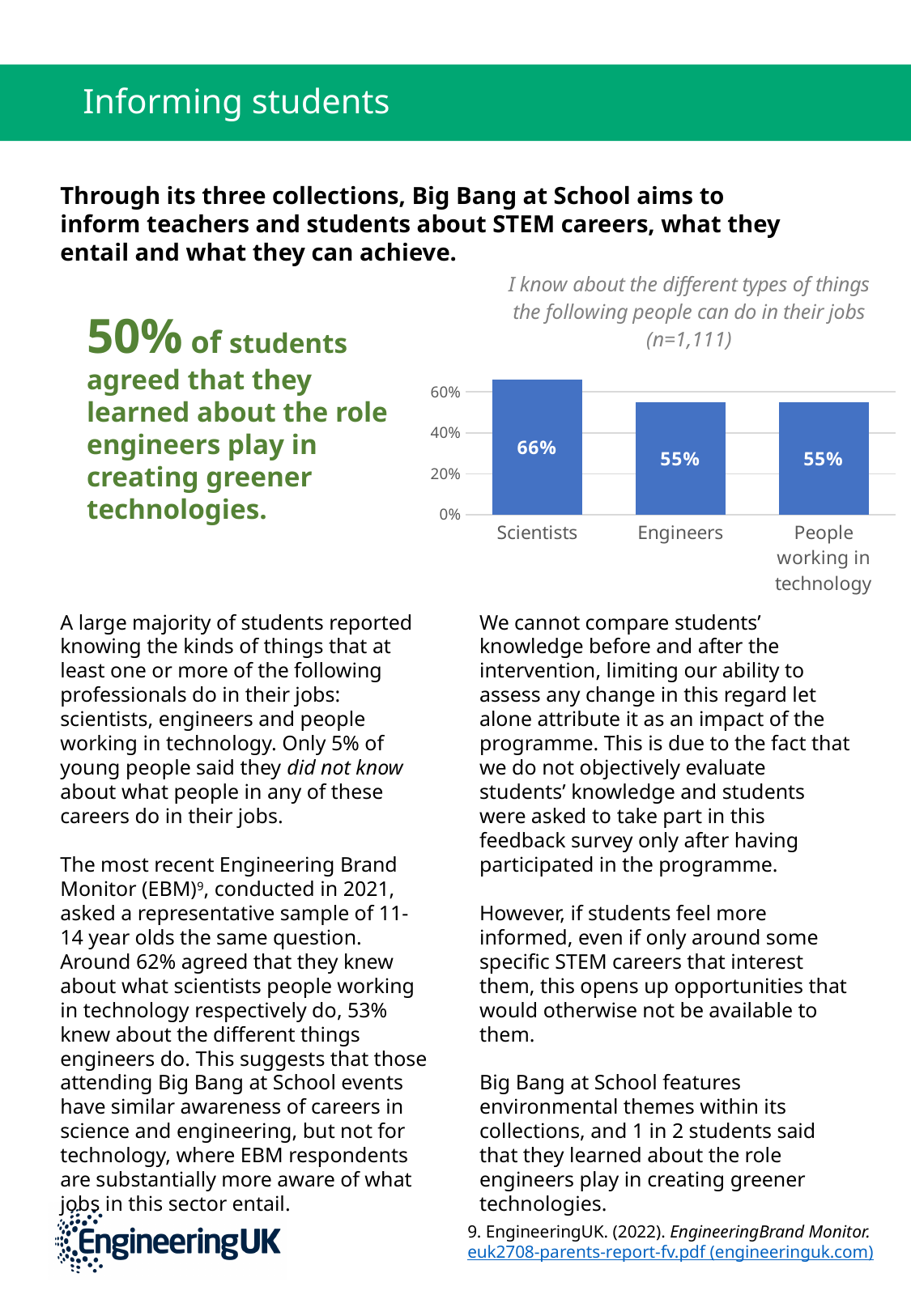
How many categories are shown in the chart? 3 What is the highest value shown on the y axis? 60% What is the value for Scientists? 66% What is the difference between the values for Scientists and Engineers? 11% What is the sample size (n) given in the chart title? 1,111 What kind of chart is shown? Bar chart Is the value for Scientists greater or less than 60%? greater Is the value for Engineers greater or less than 40%? greater Which is larger, the value for Scientists or the value for People working in technology? Scientists What is the value for Engineers? 55% Which category has the highest value? Scientists What is the value for People working in technology? 55%